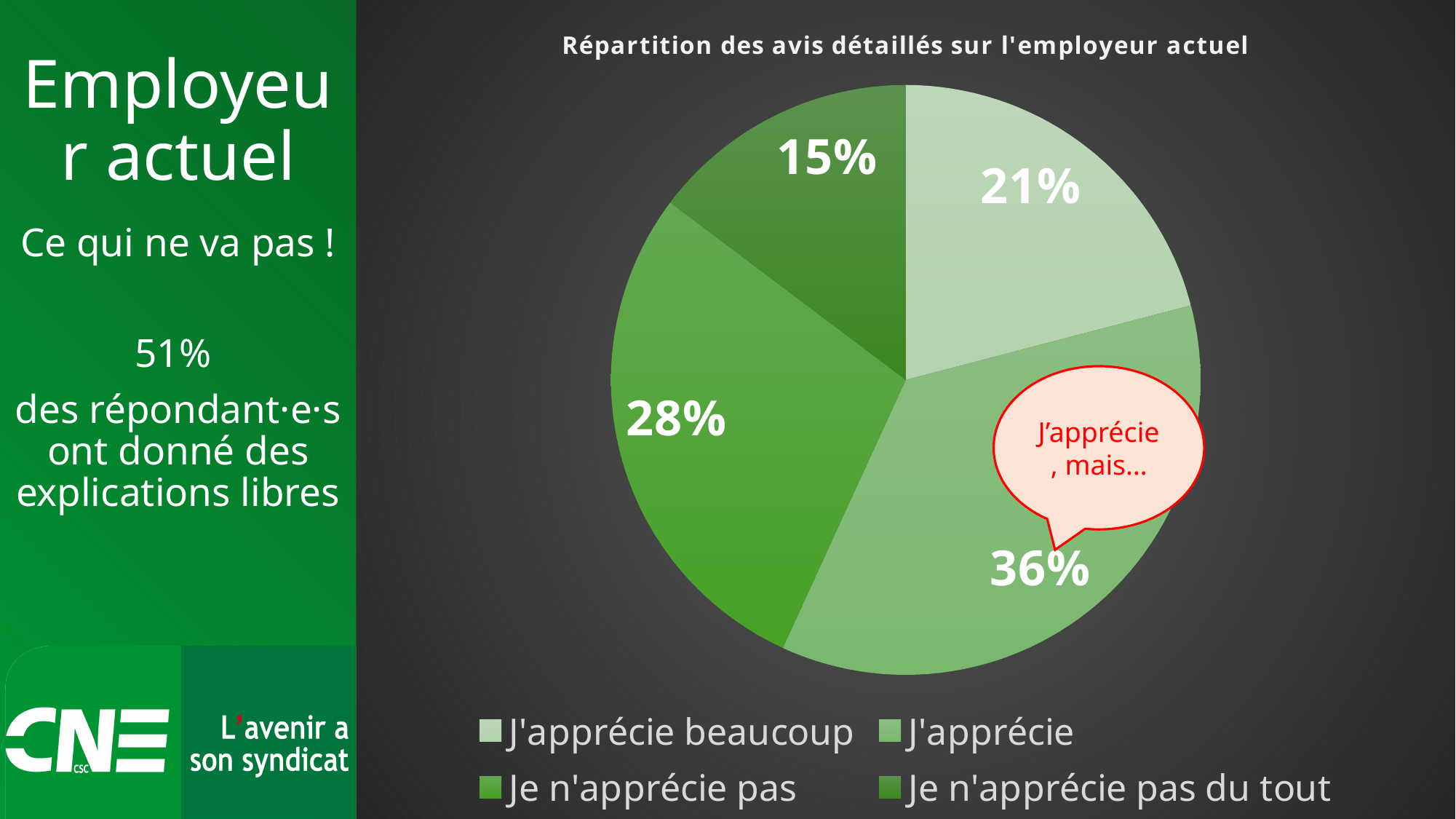
What is the title of the chart? Répartition des avis détaillés sur l'employeur actuel What share of the pie is 'Je n'apprécie pas du tout'? 15% Which category has the largest slice of the pie? J'apprécie What share of the pie is 'Je n'apprécie pas'? 28% What share of the pie is 'J'apprécie beaucoup'? 21% What text is written in the red speech bubble on the chart? J'apprécie, mais… How many slices does the pie chart have? 4 Which is larger, the share for 'J'apprécie beaucoup' or the share for 'Je n'apprécie pas'? Je n'apprécie pas What kind of chart is shown on the slide? pie chart Which category has the smallest slice of the pie? Je n'apprécie pas du tout What share of the pie is 'J'apprécie'? 36% What is the difference between the shares for 'J'apprécie' and 'Je n'apprécie pas'? 8%